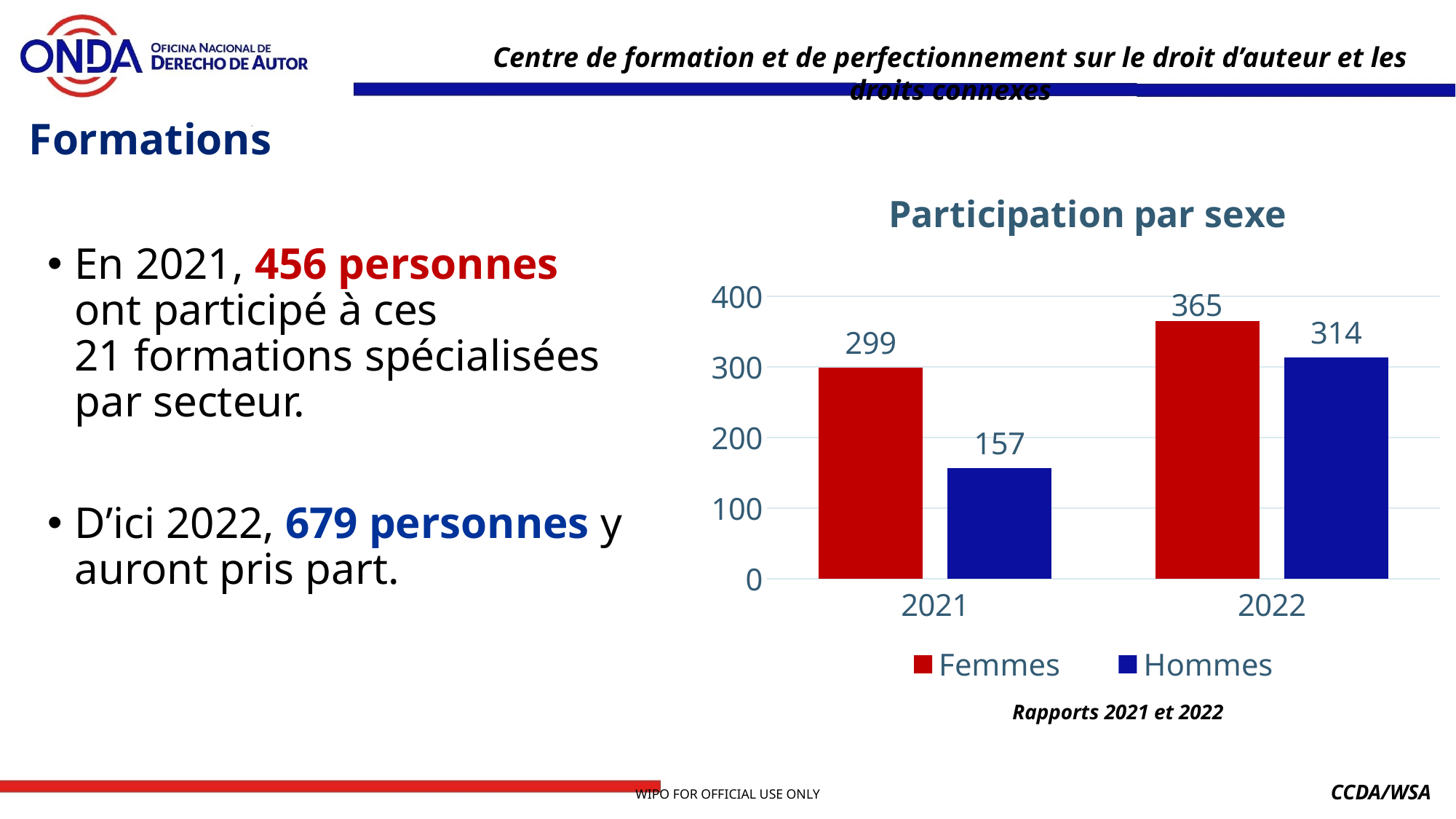
What is the value for Hommes in 2022? 314 What kind of chart is shown? Bar chart Which bar has the lowest value in the chart? Hommes in 2021 Does the value for Hommes rise or fall from 2021 to 2022? Rise What is the difference between Femmes and Hommes in 2021? 142 What is the value for Femmes in 2021? 299 What is the value for Hommes in 2021? 157 What is the title of the chart? Participation par sexe What is the value for Femmes in 2022? 365 Which is larger: Hommes in 2022 or Femmes in 2021? Hommes in 2022 Which series has the highest value in 2022? Femmes How many series does the legend list? 2